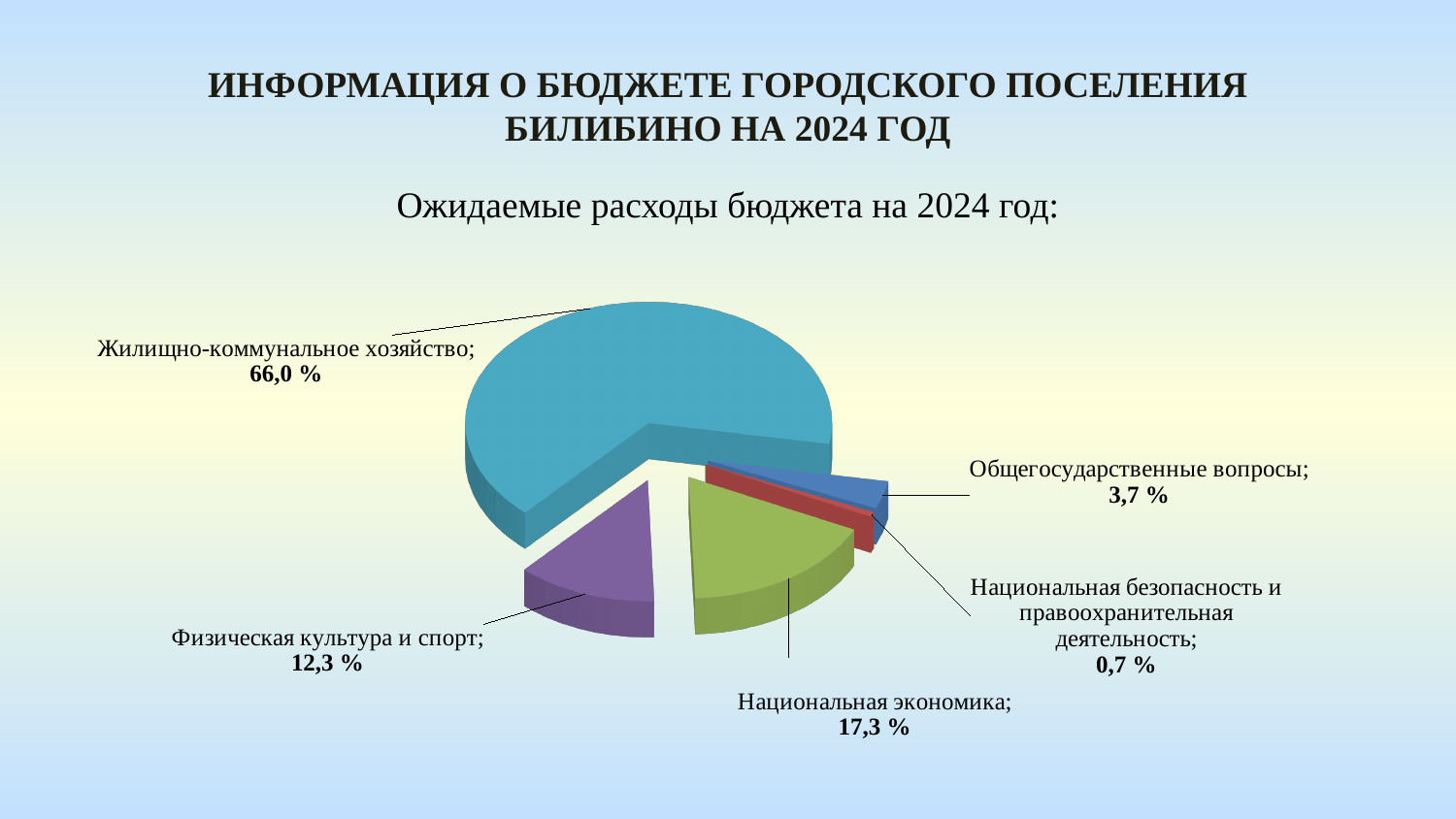
How many slices does the pie chart have? 5 What type of chart is shown on the slide? Pie chart Which category has the smallest share of the pie? Национальная безопасность и правоохранительная деятельность What share of expected 2024 budget expenditures goes to Жилищно-коммунальное хозяйство? 66,0 % What is the difference in percentage points between Национальная экономика and Физическая культура и спорт? 5,0 What percentage is shown for Общегосударственные вопросы? 3,7 % Which category has the largest share of the pie? Жилищно-коммунальное хозяйство What share is labelled for Национальная безопасность и правоохранительная деятельность? 0,7 % What percentage is shown for Национальная экономика? 17,3 % What is the subtitle above the chart? Ожидаемые расходы бюджета на 2024 год: What value is labelled for Физическая культура и спорт? 12,3 % Which is larger: the share for Общегосударственные вопросы or for Физическая культура и спорт? Физическая культура и спорт